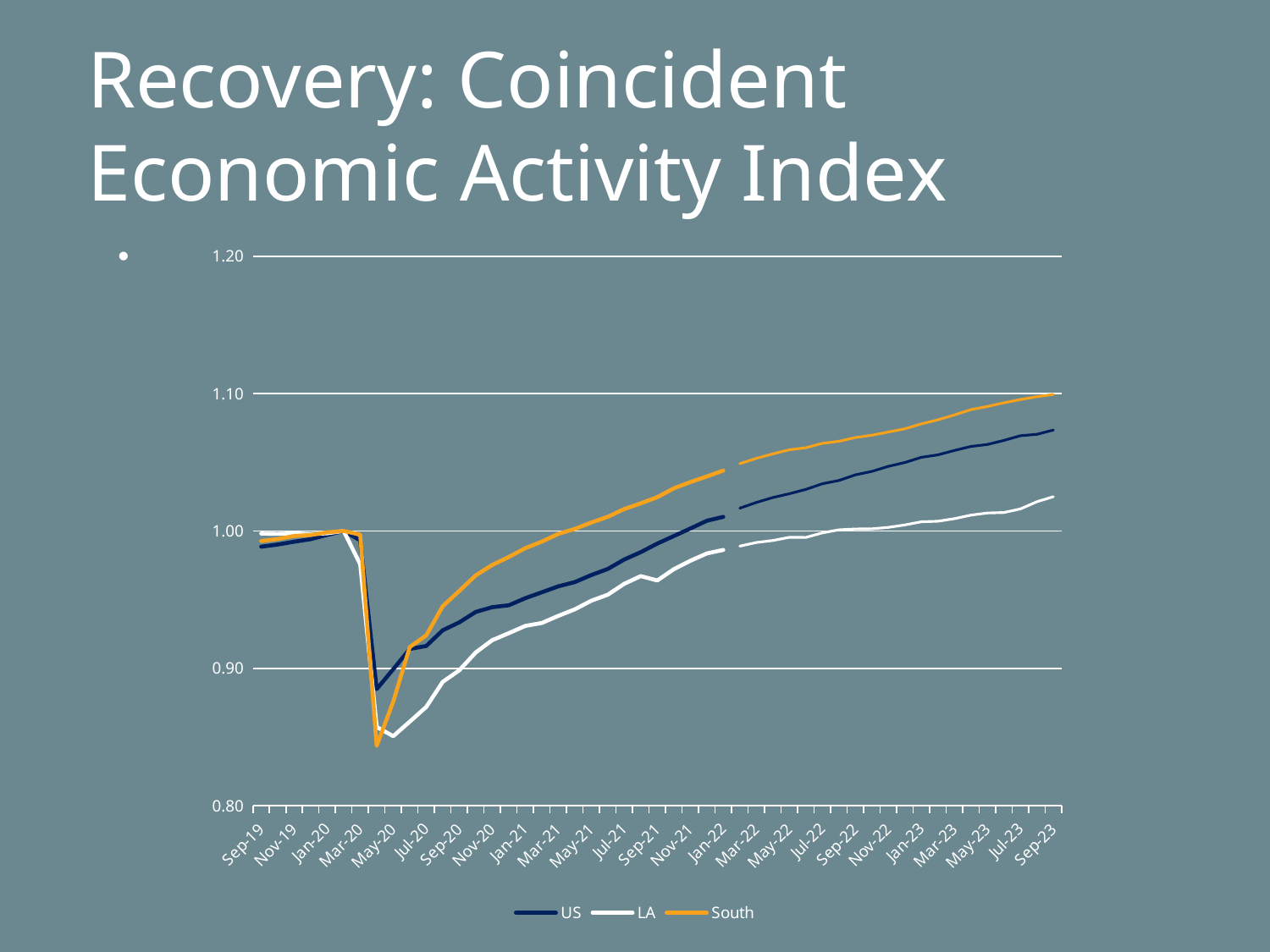
What is the lowest value shown on the vertical axis? 0.80 Do the values for South rise or fall from May-20 to Sep-23? Rise What kind of chart is shown on the slide? Line chart How many series does the legend list? 3 At Sep-23, is the value for US greater or less than 1.10? less At May-20, is the value for LA greater or less than 0.90? less Which series has the lowest value at Sep-23? LA At Sep-23, is the value for LA greater or less than 1.00? greater What is the title of the slide containing the chart? Recovery: Coincident Economic Activity Index At Sep-23, which is larger, the value for US or the value for LA? US Which series has the highest value at Sep-23? South Which series is drawn in orange? South